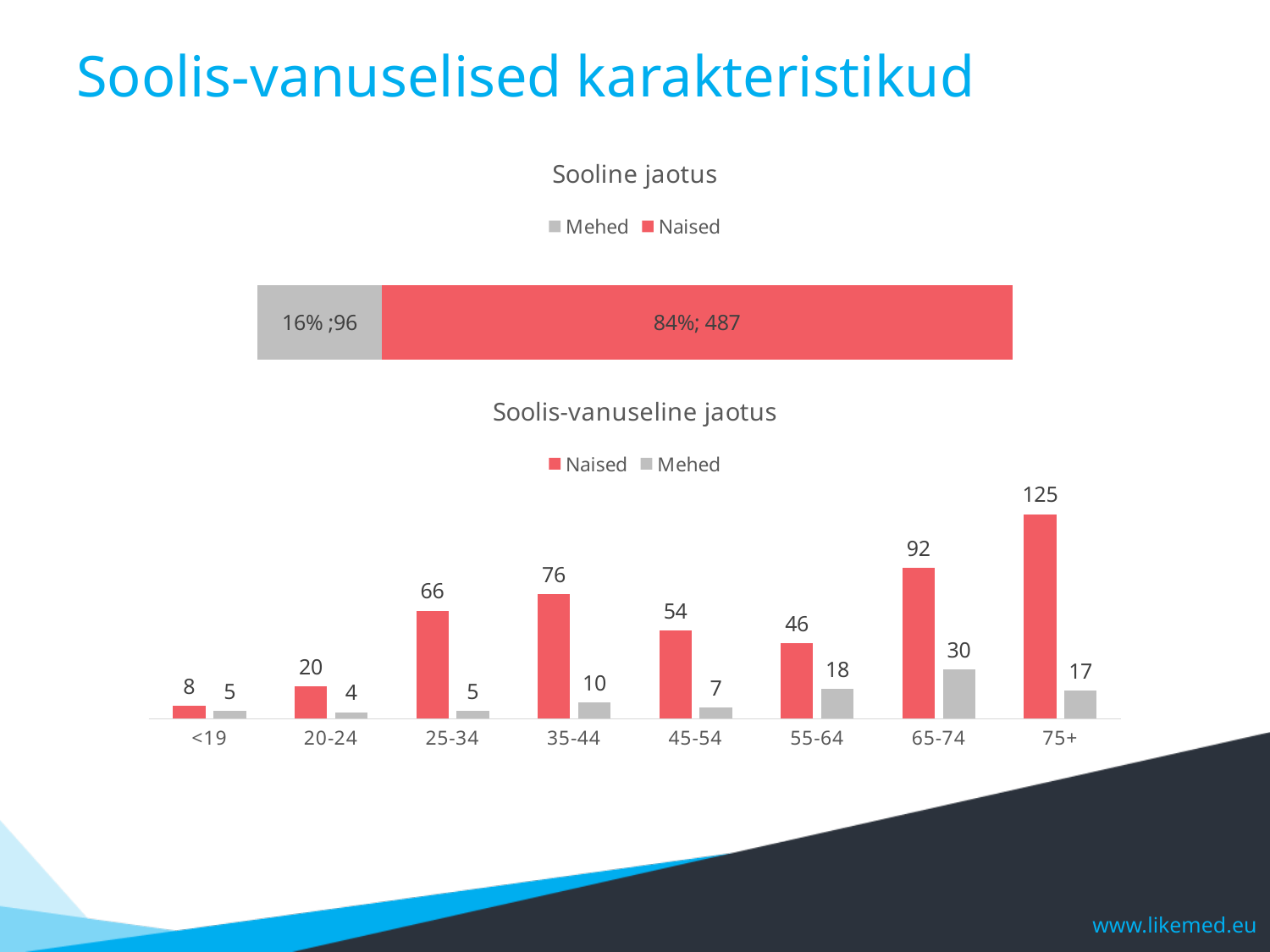
In the 'Soolis-vanuseline jaotus' chart, what is the value for Mehed in the 65-74 age group? 30 In the 'Soolis-vanuseline jaotus' chart, what colour are the Naised bars? Red In the 'Soolis-vanuseline jaotus' chart, which age group has the highest Naised value? 75+ How many age groups are shown in the 'Soolis-vanuseline jaotus' chart? 8 In the 'Sooline jaotus' chart, what is the value shown for Naised? 84%; 487 What kind of chart is 'Soolis-vanuseline jaotus'? Bar chart In the 'Soolis-vanuseline jaotus' chart, which age group has the lowest Mehed value? 20-24 How many series does the legend of the 'Soolis-vanuseline jaotus' chart list? 2 In the 'Soolis-vanuseline jaotus' chart, which is larger: Naised for 25-34 or Naised for 35-44? Naised for 35-44 In the 'Sooline jaotus' chart, what is the value shown for Mehed? 16% ;96 In the 'Soolis-vanuseline jaotus' chart, what is the value for Naised in the 75+ age group? 125 In the 'Soolis-vanuseline jaotus' chart, what is the difference between the Naised values for 65-74 and 55-64? 46